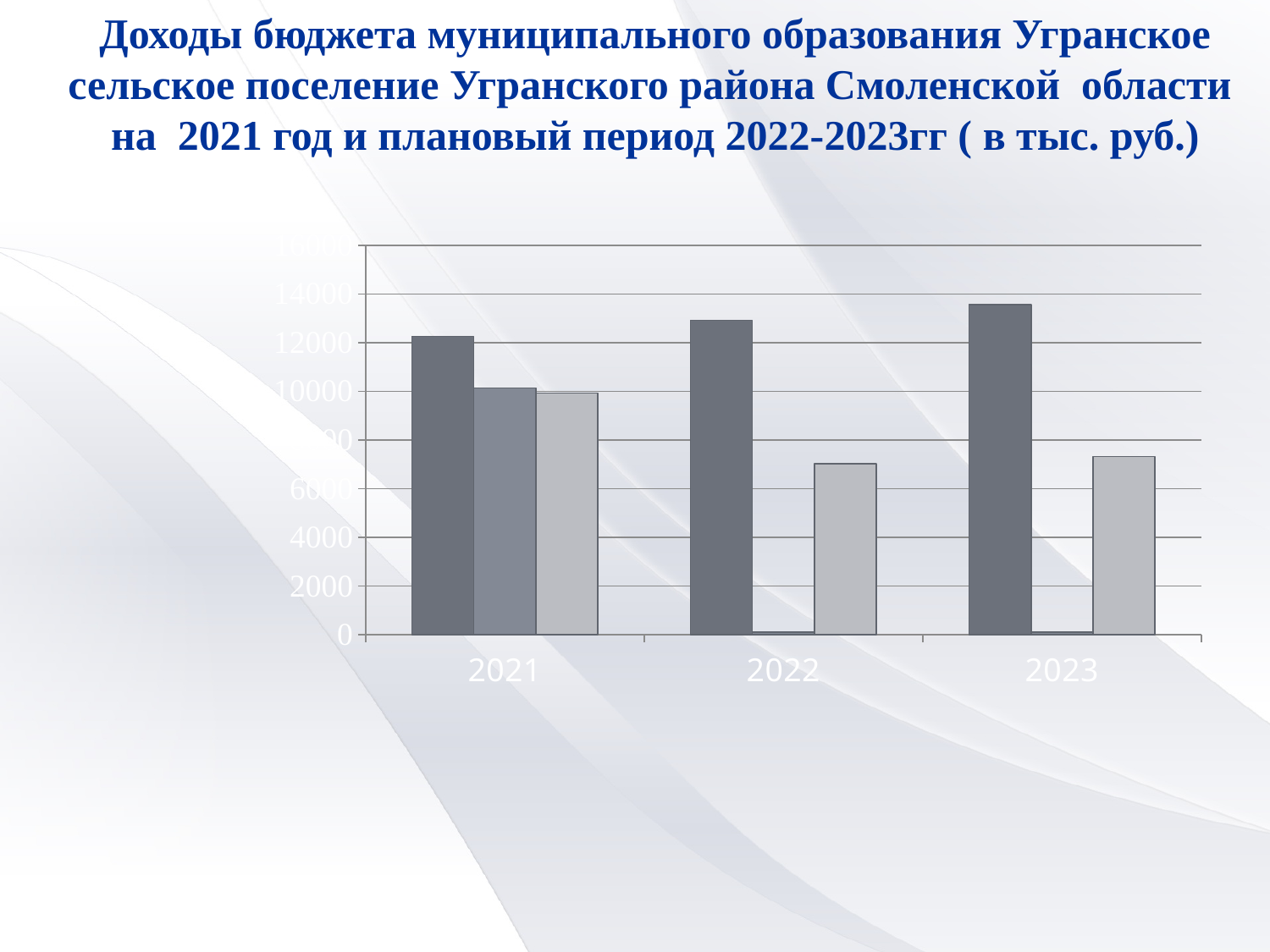
Is the dark-gray (first) bar for 2023 greater or less than 12000? greater What kind of chart is shown on the slide? bar chart Is the medium-gray (second) bar for 2021 greater or less than 8000? greater In what units are the budget revenues given according to the slide title? тыс. руб. How many year categories are shown on the x axis? 3 Is the dark-gray (first) bar for 2021 greater or less than 10000? greater Which year has the tallest light-gray (third) bar? 2021 For 2022, which is larger: the dark-gray (first) bar or the light-gray (third) bar? the dark-gray (first) bar How many bars are plotted for each year group? 3 Do the dark-gray (first) bars rise or fall from 2021 to 2023? rise Which year has the tallest dark-gray (first) bar? 2023